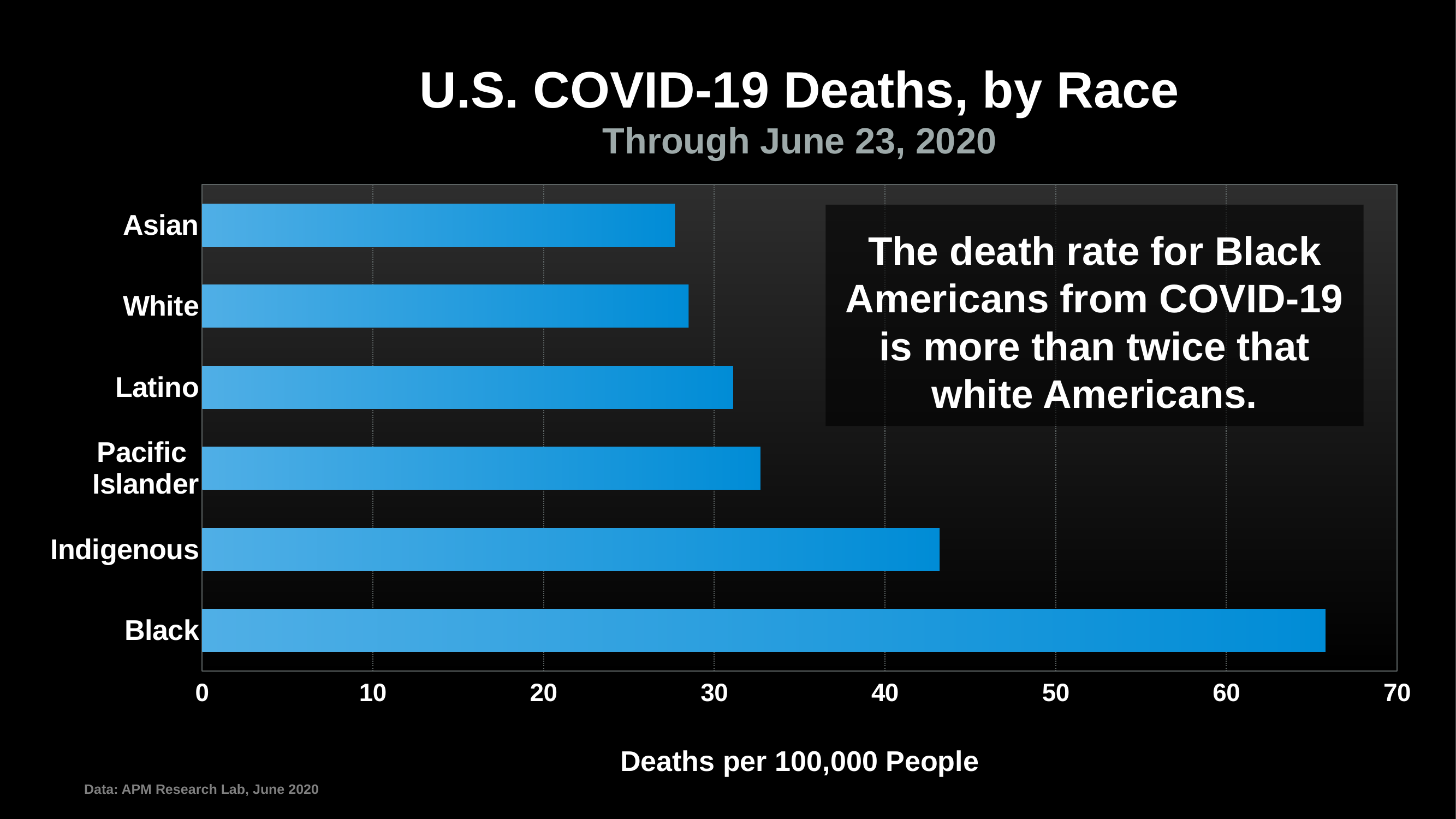
What is the title of the chart? U.S. COVID-19 Deaths, by Race Is the value for Black greater or less than 60? greater What kind of chart is shown on the slide? bar chart Is the value for Indigenous greater or less than 50? less Which racial group has the highest COVID-19 death rate in the chart? Black What is the label on the x axis of the chart? Deaths per 100,000 People Is the value for Pacific Islander greater or less than 30? greater Which has a higher death rate, Indigenous or Pacific Islander? Indigenous Which has a higher death rate, Black or Indigenous? Black How many racial groups are plotted in the chart? 6